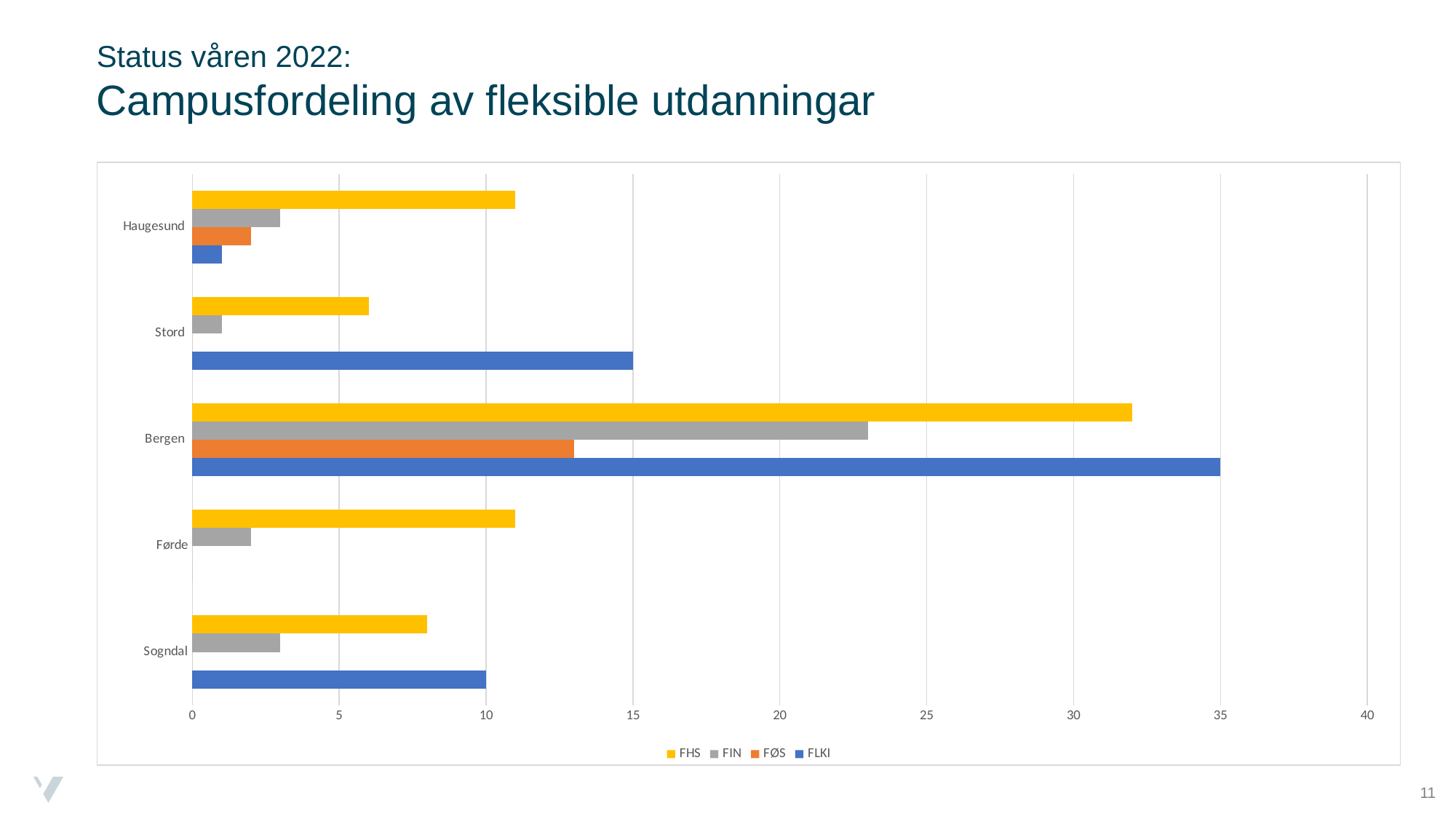
Which is larger for Bergen, the FHS value or the FIN value? FHS What type of chart is shown on the slide? bar chart Which series is shown in blue in the legend? FLKI What is the FLKI value for Sogndal? 10 What is the FLKI value for Bergen? 35 How many series does the legend list? 4 What is the difference between the FLKI values for Bergen and Stord? 20 What is the FLKI value for Stord? 15 Is the FHS value for Bergen greater or less than 30? greater How many campuses (categories) are shown on the chart? 5 Which campus has the highest FLKI value? Bergen Which campus has the highest FHS value? Bergen